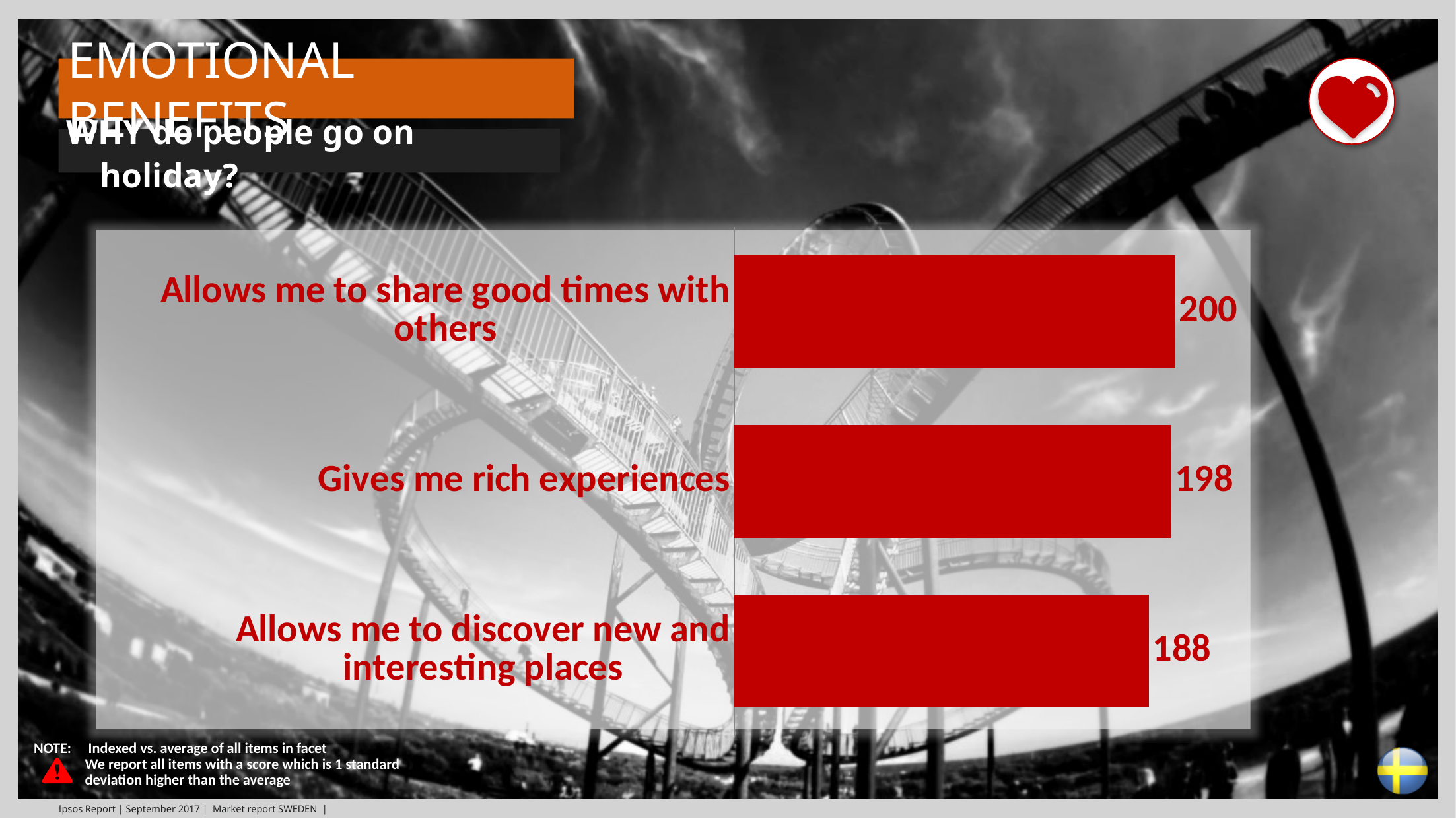
What is the value for "Gives me rich experiences"? 198 What is the difference between the values for "Allows me to share good times with others" and "Allows me to discover new and interesting places"? 12 Which is larger: the value for "Gives me rich experiences" or the value for "Allows me to discover new and interesting places"? Gives me rich experiences Which category has the lowest value? Allows me to discover new and interesting places What is the difference between the values for "Gives me rich experiences" and "Allows me to discover new and interesting places"? 10 What is the value for "Allows me to discover new and interesting places"? 188 What is the value for "Allows me to share good times with others"? 200 What colour are the bars in the chart? Red How many categories are shown in the chart? 3 What kind of chart is shown on the slide? Bar chart Which category has the highest value? Allows me to share good times with others What question does the chart address, according to the heading above it? Why do people go on holiday?